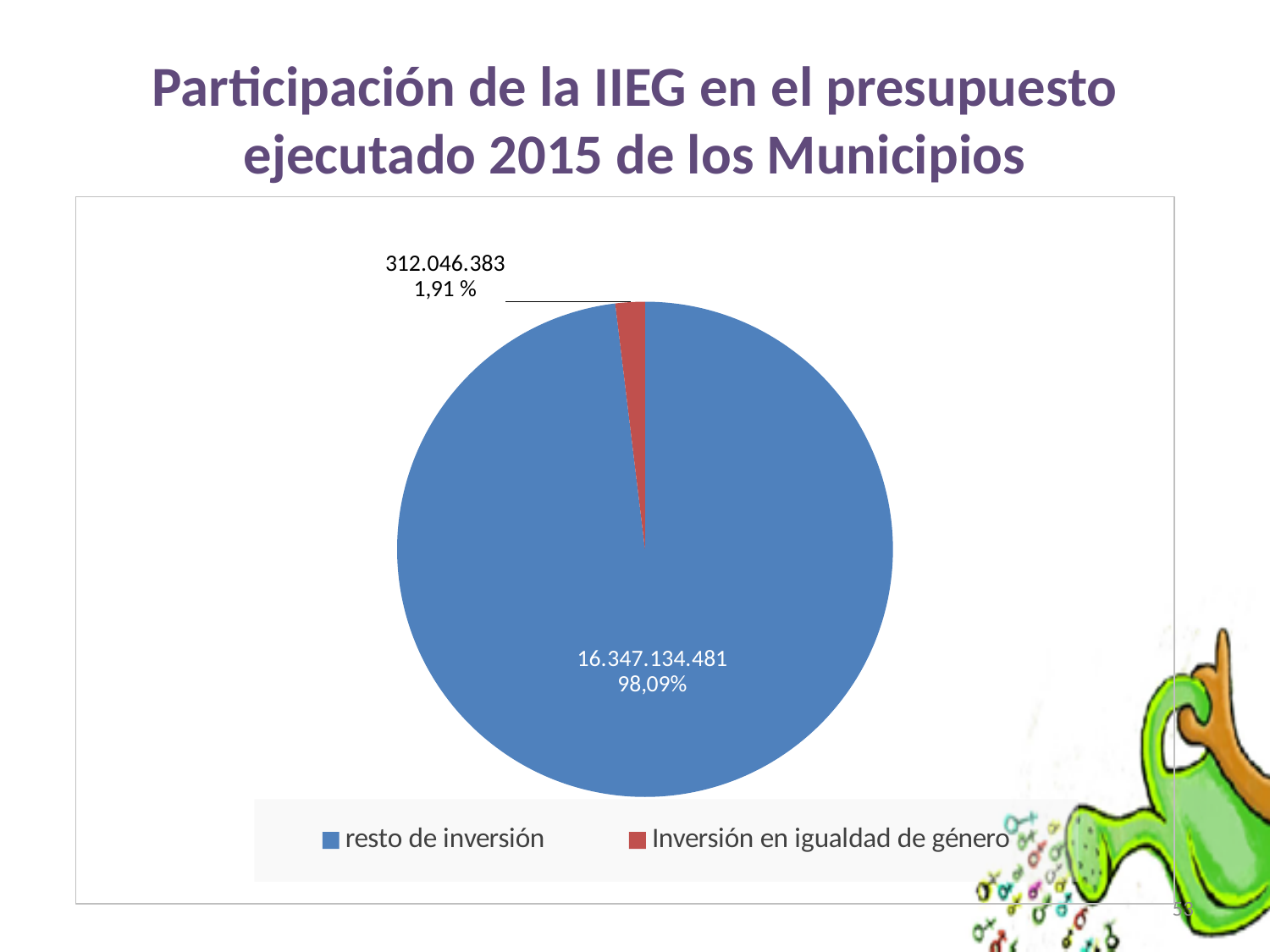
Which slice is the largest? resto de inversión What kind of chart is shown on the slide? pie chart Which slice is the smallest? Inversión en igualdad de género What is the value for 'resto de inversión'? 16.347.134.481 How many entries does the legend list? 2 How many slices does the pie chart have? 2 What share of the pie does 'Inversión en igualdad de género' represent? 1,91 % Which is larger, 'resto de inversión' or 'Inversión en igualdad de género'? resto de inversión What share of the pie does 'resto de inversión' represent? 98,09% What colour is the 'Inversión en igualdad de género' slice? red What is the value for 'Inversión en igualdad de género'? 312.046.383 What is the title of the slide? Participación de la IIEG en el presupuesto ejecutado 2015 de los Municipios